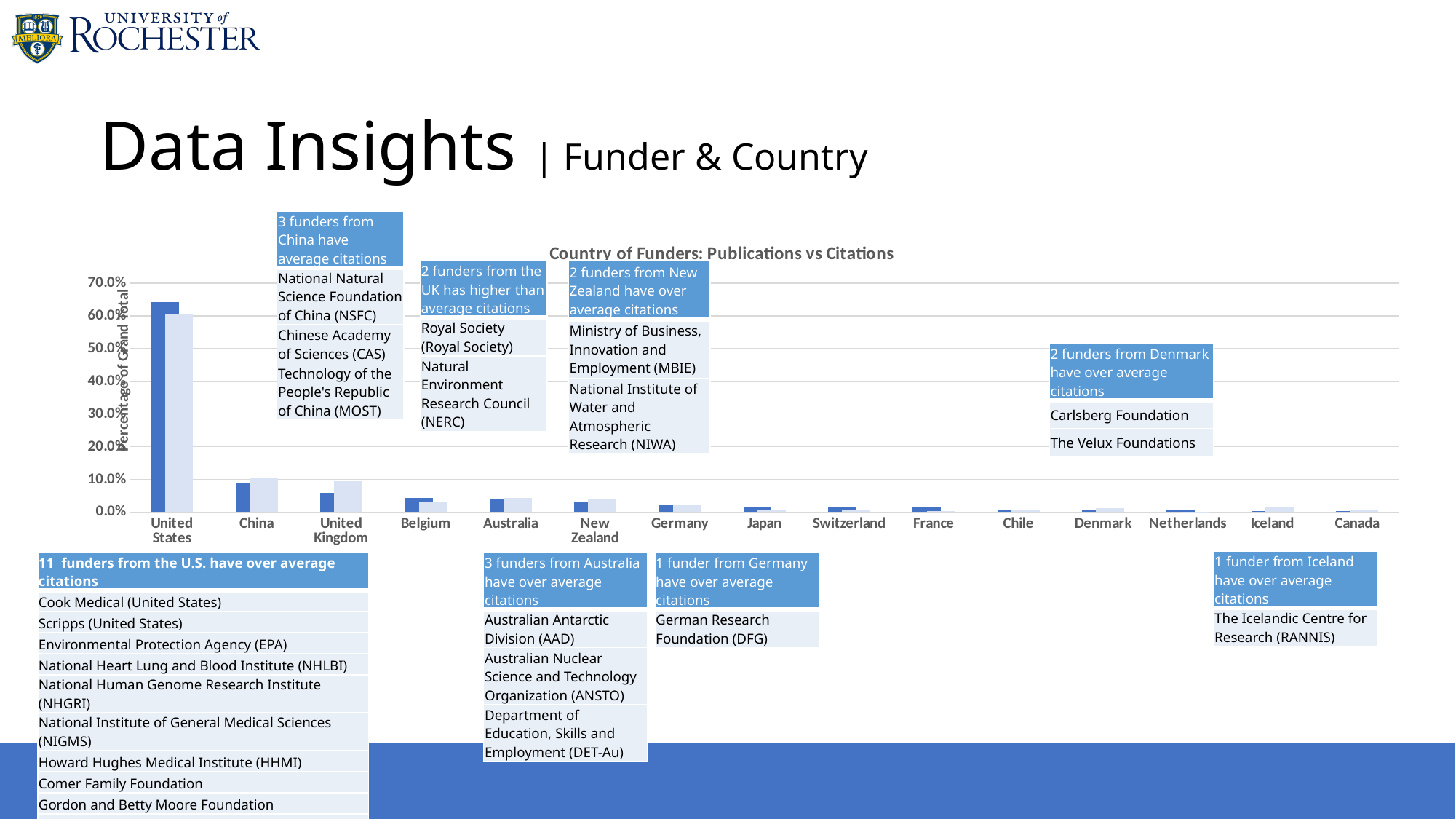
What is the label on the vertical axis of the chart? Percentage of Grand Total Do the values generally rise or fall moving from left to right along the x axis? fall What kind of chart is shown on the slide? bar chart Which country has the highest values in the chart? United States Is the value of the dark blue bar for Germany greater or less than 10.0%? less How many countries are shown on the x axis of the chart? 15 Is the value of the light blue bar for China greater or less than 20.0%? less Which country has larger values, United States or China? United States Is the value of the dark blue bar for United States greater or less than 50.0%? greater What is the title of the chart? Country of Funders: Publications vs Citations How many bars are plotted for each country in the chart? 2 Which country has larger values, China or Japan? China